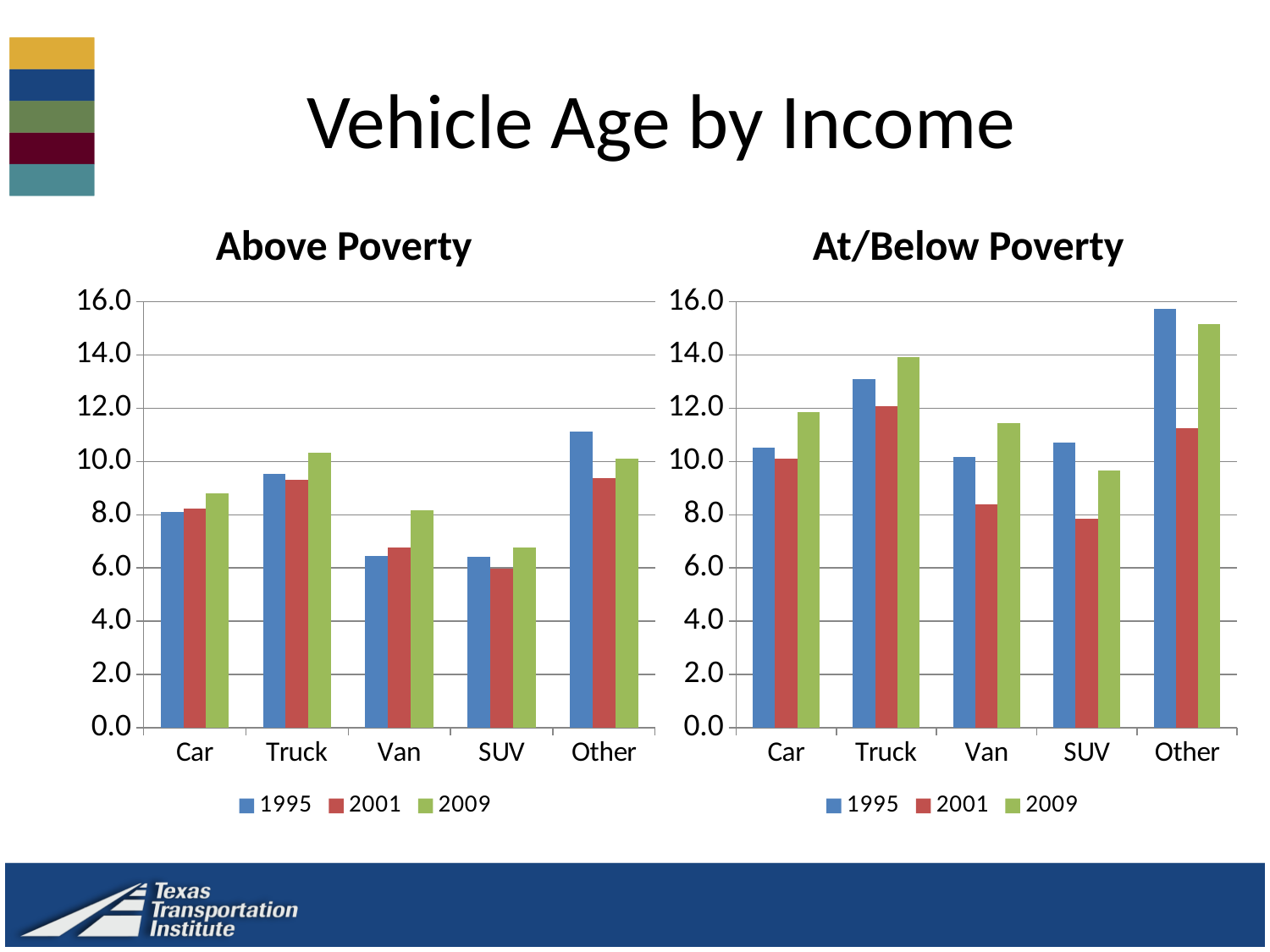
In the Above Poverty chart, is the 1995 value for Other greater or less than 10.0? greater In the At/Below Poverty chart, which vehicle category has the highest value for 1995? Other In the At/Below Poverty chart, which is larger for 2009: Truck or Car? Truck How many vehicle categories are shown on the x axis of the At/Below Poverty chart? 5 What kind of chart is the Above Poverty chart? bar chart In the At/Below Poverty chart, which vehicle category has the lowest value for 2001? SUV What are the titles of the two charts on the slide? Above Poverty and At/Below Poverty How many series does the legend of the Above Poverty chart list? 3 In the At/Below Poverty chart, is the 1995 value for Other greater or less than 14.0? greater In the Above Poverty chart, which vehicle category has the highest value for 1995? Other In the Above Poverty chart, which vehicle category has the lowest value for 2001? SUV In the Above Poverty chart, is the 2001 value for SUV greater or less than 8.0? less